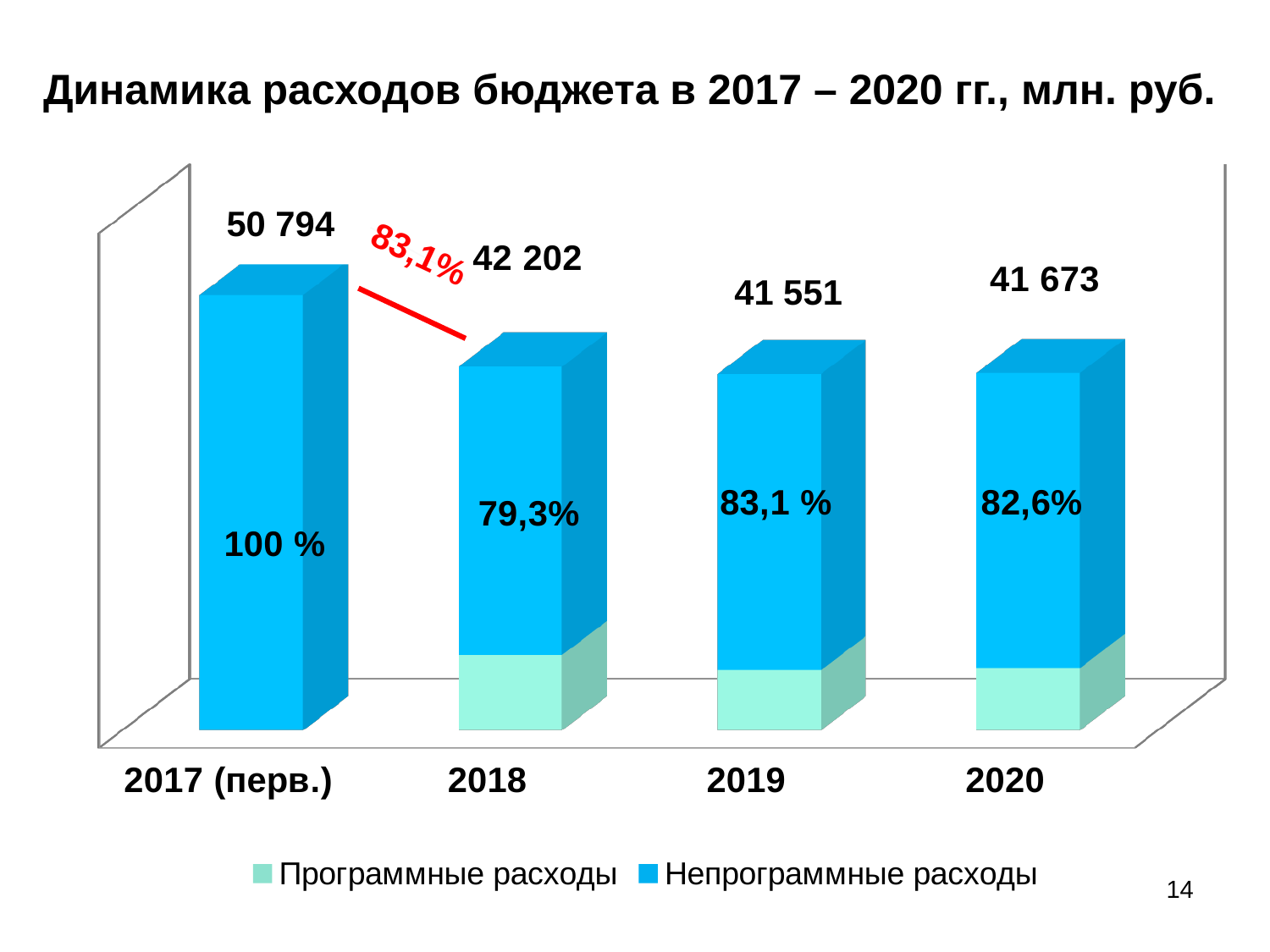
What kind of chart is shown on the slide? Stacked bar chart What is the total value labelled above the 2020 bar? 41 673 What is the total value labelled above the 2019 bar? 41 551 Which total is larger, 2019 or 2020? 2020 Which series does the light green colour represent in the legend? Программные расходы Which year has the lowest total budget expenditure? 2019 How many series does the legend list? 2 What is the total budget expenditure shown for 2018? 42 202 What percentage label is printed on the 2018 bar? 79,3% Which year has the highest total budget expenditure? 2017 (перв.) By how much does the total for 2017 (перв.) exceed the total for 2018? 8 592 How many years (categories) are shown on the x axis? 4